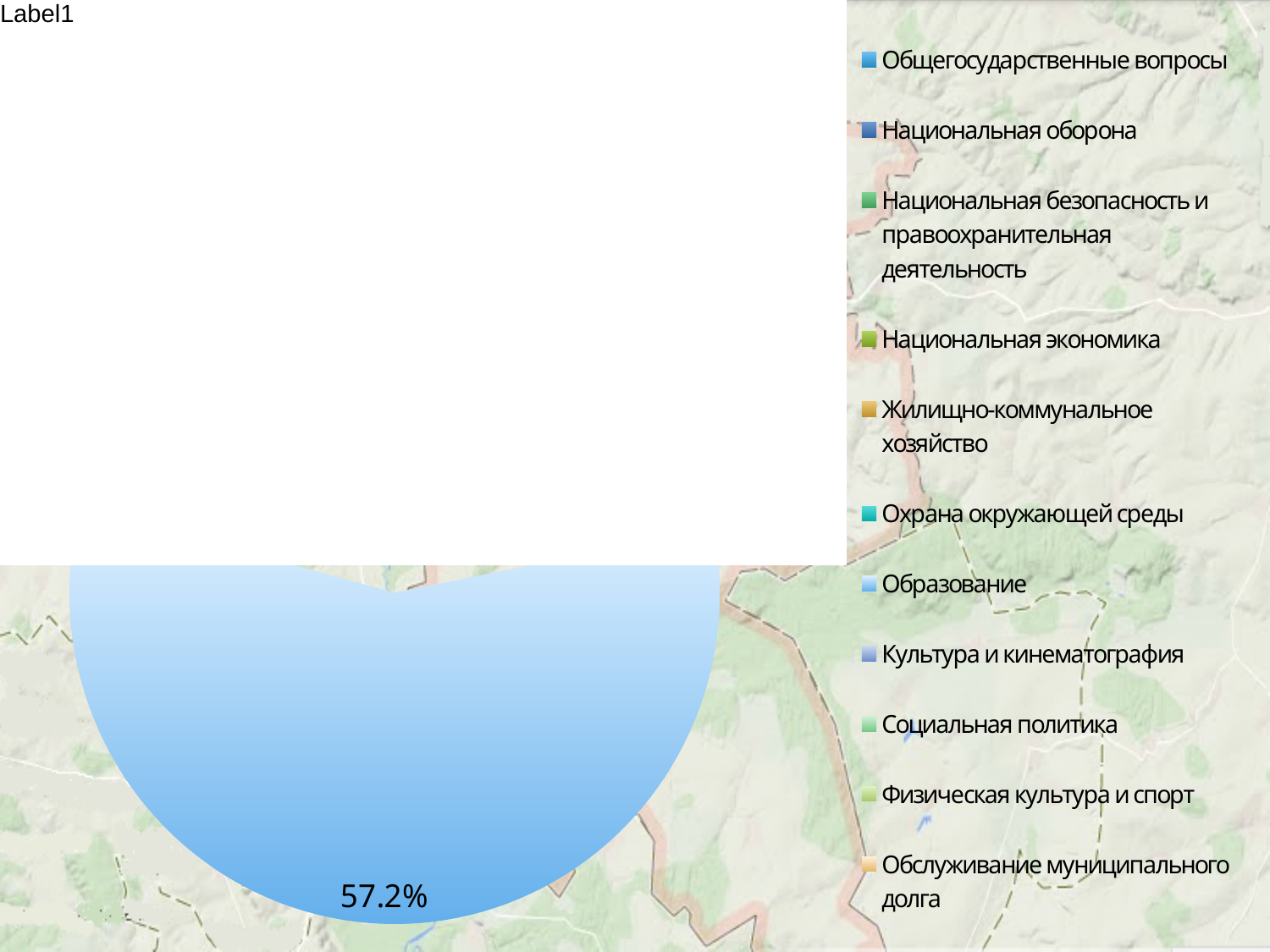
What kind of chart is shown on the slide? pie chart Is the share of the visible slice of the pie chart greater or less than 50%? greater What is the first entry listed in the chart's legend? Общегосударственные вопросы What percentage is printed on the visible slice of the pie chart? 57.2% What is the last entry listed in the chart's legend? Обслуживание муниципального долга How many entries does the chart's legend list? 11